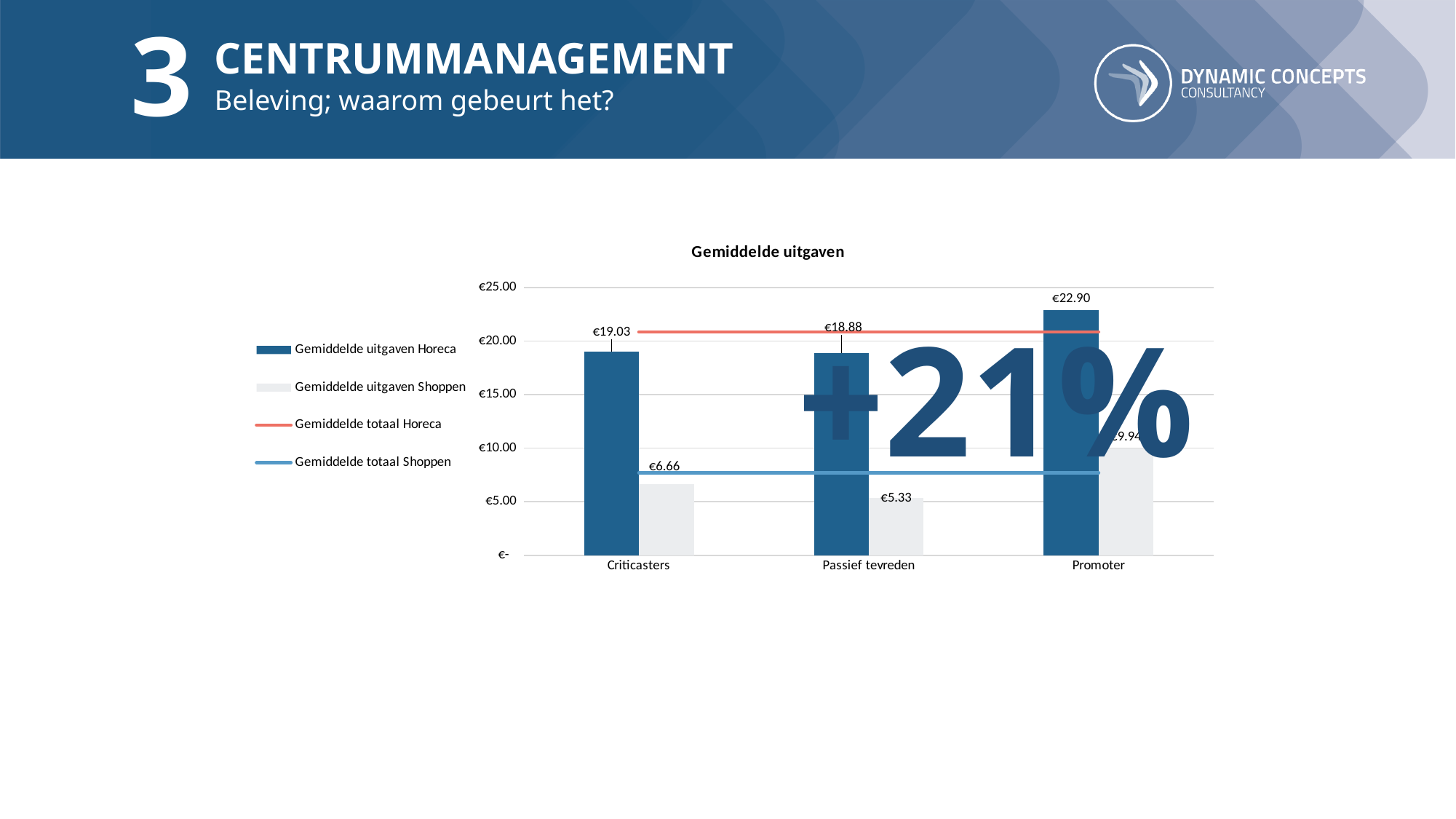
What is the value of Gemiddelde uitgaven Shoppen for Criticasters? €6.66 Which category has the highest Gemiddelde uitgaven Horeca? Promoter Which category has the lowest Gemiddelde uitgaven Shoppen? Passief tevreden What is the value of Gemiddelde uitgaven Horeca for Passief tevreden? €18.88 For Criticasters, which is larger: Gemiddelde uitgaven Horeca or Gemiddelde uitgaven Shoppen? Gemiddelde uitgaven Horeca What is the value of Gemiddelde uitgaven Shoppen for Passief tevreden? €5.33 How many categories are shown on the x axis of the chart? 3 What is the value of Gemiddelde uitgaven Horeca for Promoter? €22.90 How many series does the chart legend list? 4 Is the Gemiddelde totaal Horeca line greater or less than €20.00? greater What is the difference between Gemiddelde uitgaven Horeca for Promoter and for Criticasters? €3.87 What is the value of Gemiddelde uitgaven Horeca for Criticasters? €19.03